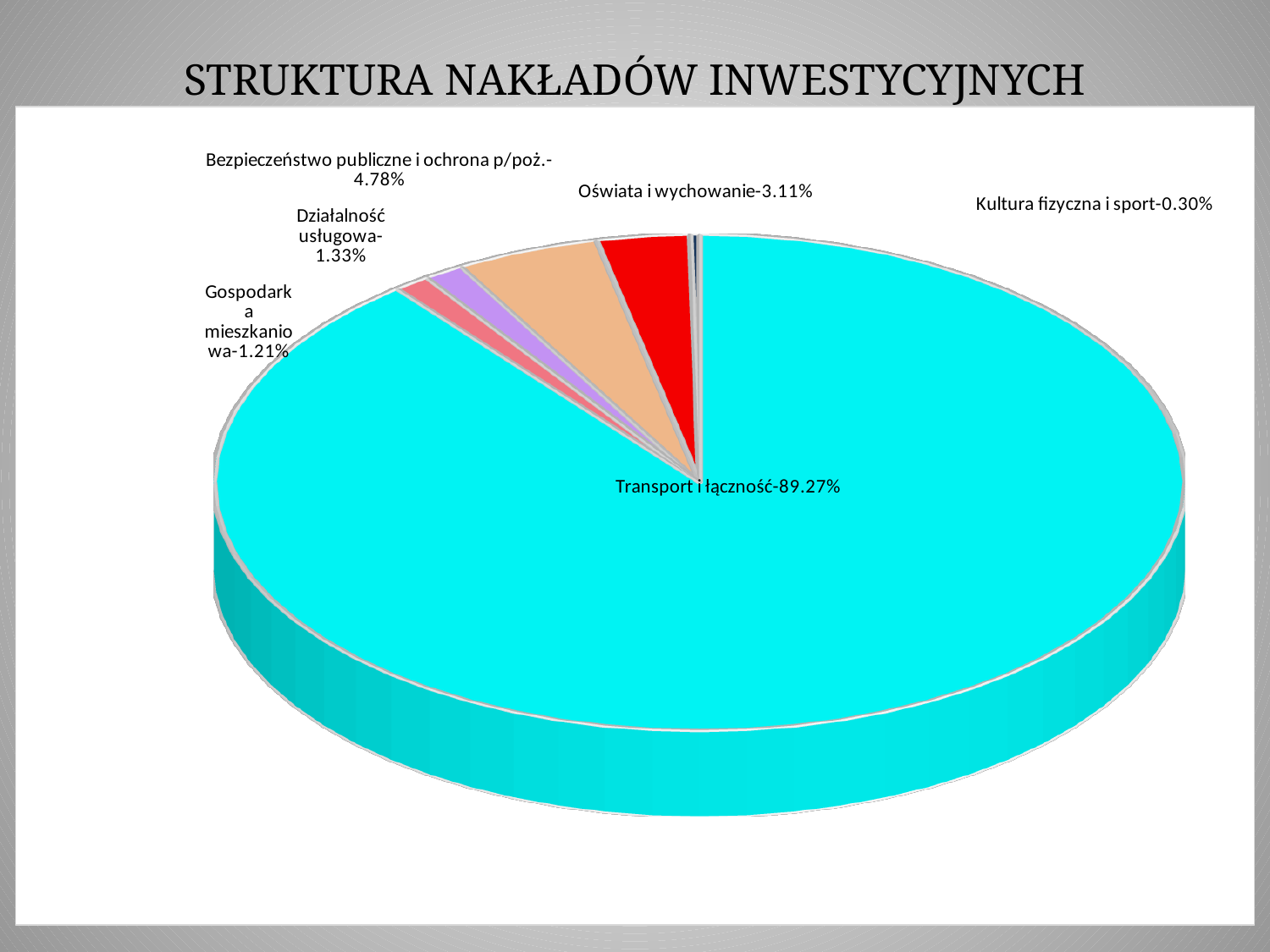
What share of the pie does Transport i łączność have? 89.27% What is the difference between the shares for Bezpieczeństwo publiczne i ochrona p/poż. and Oświata i wychowanie? 1.67% What kind of chart is shown on the slide? Pie chart Which is larger, the share for Oświata i wychowanie or the share for Działalność usługowa? Oświata i wychowanie What share of the pie does Bezpieczeństwo publiczne i ochrona p/poż. have? 4.78% Which category has the smallest share of the pie? Kultura fizyczna i sport Which category has the largest share of the pie? Transport i łączność What is the title of the chart on the slide? STRUKTURA NAKŁADÓW INWESTYCYJNYCH How many slices does the pie chart have? 6 What share of the pie does Oświata i wychowanie have? 3.11%